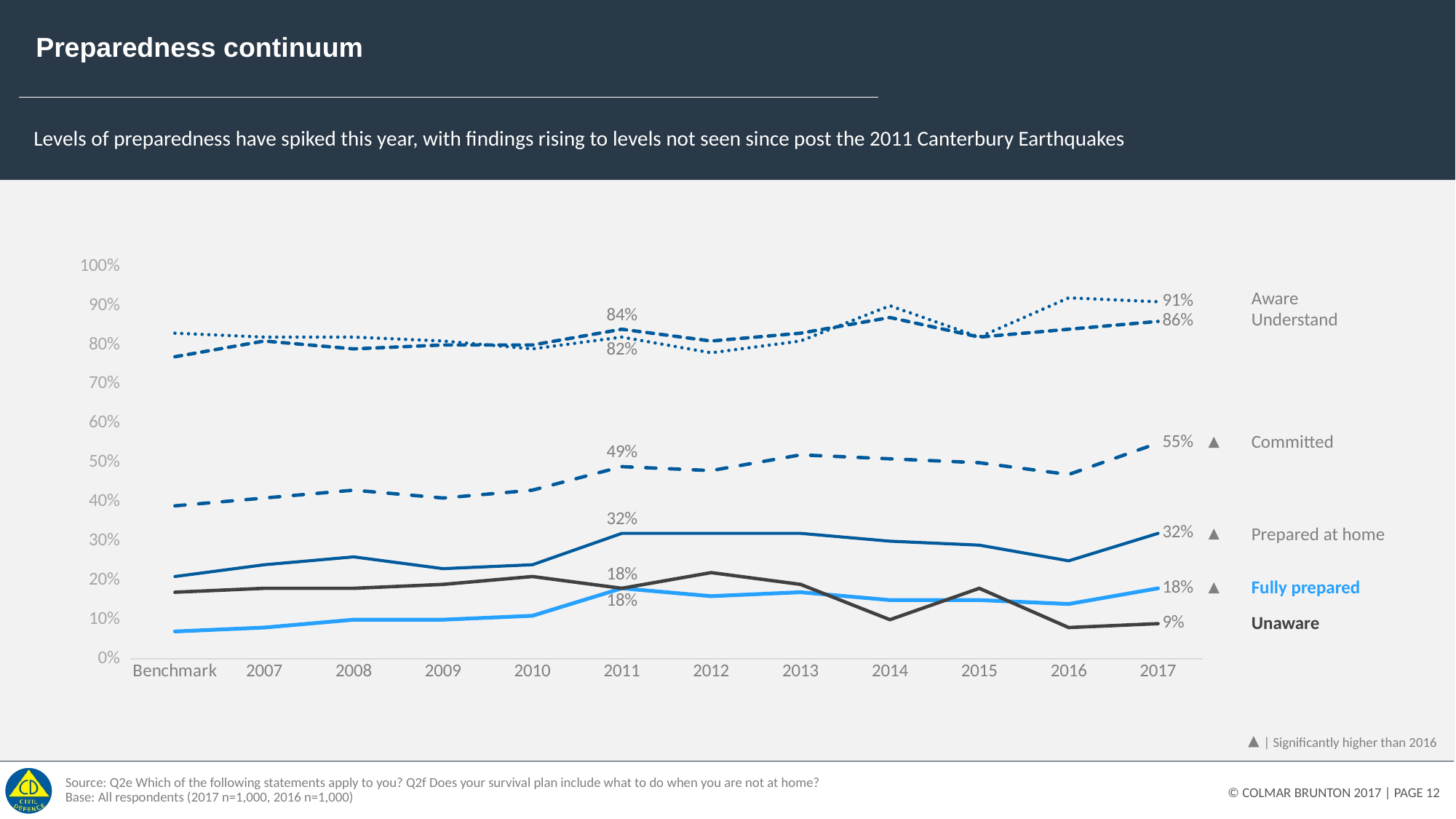
Which series has the highest value in 2017? Aware Is the value for Prepared at home in 2008 greater or less than 30%? less What is the value for Unaware in 2017? 9% What is the value for Committed in 2011? 49% By how many percentage points did Committed change from 2011 to 2017? 6 percentage points What is the difference between Aware and Understand in 2017? 5 percentage points Which is larger in 2017, Prepared at home or Fully prepared? Prepared at home What is the value for Aware in 2017? 91% Which series has the lowest value in 2017? Unaware What kind of chart is shown on the slide? Line chart How many points are shown along the x axis? 12 What is the value for Committed in 2017? 55%